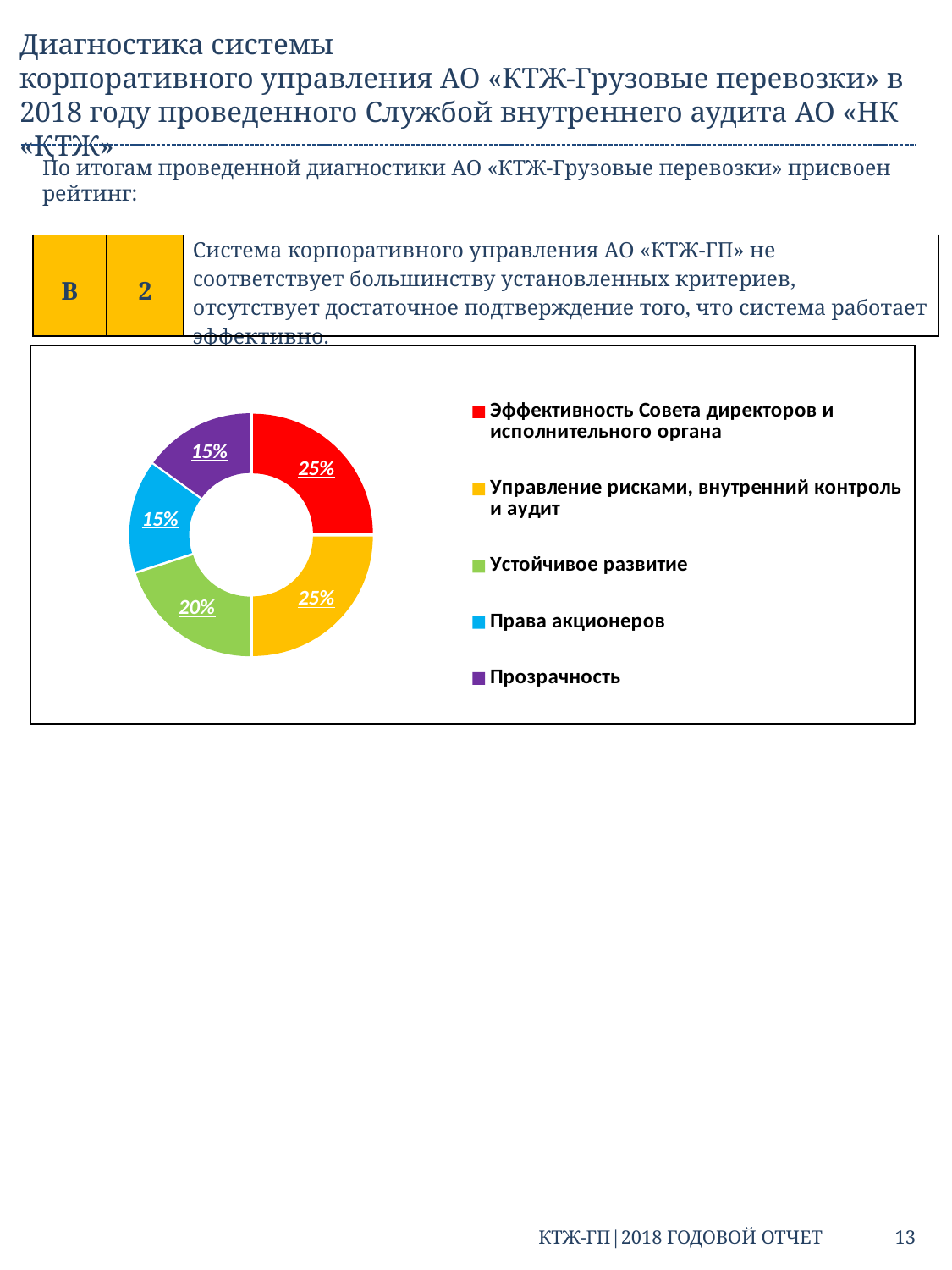
Which is larger in the doughnut chart: "Устойчивое развитие" or "Права акционеров"? Устойчивое развитие What share of the doughnut chart is labelled "Устойчивое развитие"? 20% What percentage is shown for "Эффективность Совета директоров и исполнительного органа"? 25% What is the difference between the shares of "Устойчивое развитие" and "Права акционеров"? 5% What is the difference between the shares of "Управление рисками, внутренний контроль и аудит" and "Прозрачность"? 10% Which colour represents "Устойчивое развитие" in the doughnut chart? green How many entries does the legend of the doughnut chart list? 5 How many slices does the doughnut chart have? 5 What percentage is shown for "Права акционеров" in the doughnut chart? 15% What percentage is shown for "Прозрачность" in the doughnut chart? 15% What kind of chart is shown on the slide? doughnut chart What percentage is shown for "Управление рисками, внутренний контроль и аудит"? 25%